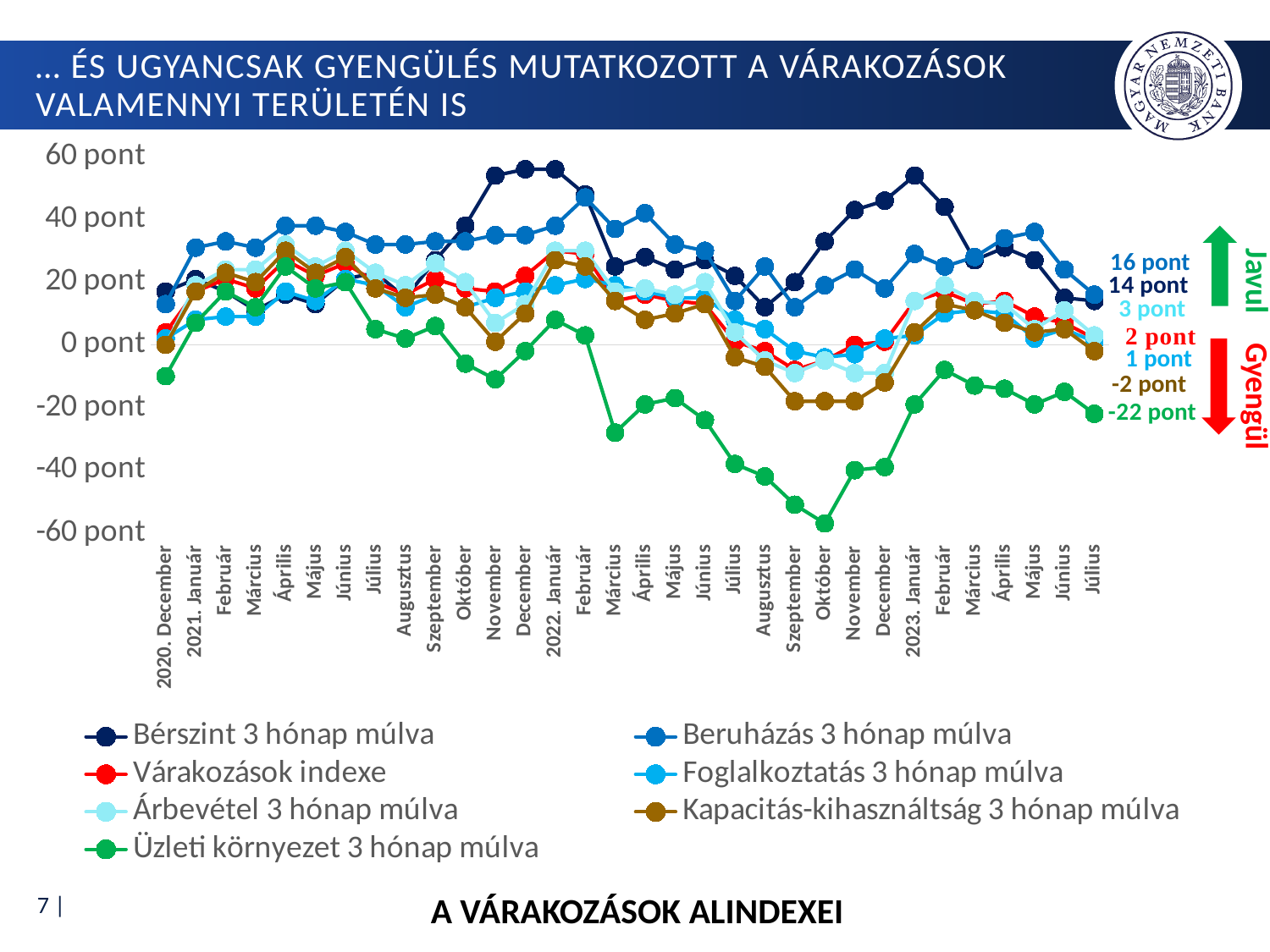
At the end of the chart, which is larger: the value for Árbevétel 3 hónap múlva or for Foglalkoztatás 3 hónap múlva? Árbevétel 3 hónap múlva What is the final value labelled for Várakozások indexe? 2 pont Which series has the highest labelled value at the end of the chart (2023 Július)? Beruházás 3 hónap múlva Is the value for Üzleti környezet 3 hónap múlva in 2022 Október greater or less than -40 pont? less What is the difference between the final labelled values of Beruházás 3 hónap múlva (16 pont) and Kapacitás-kihasználtság 3 hónap múlva (-2 pont)? 18 pont What is the final value labelled for Üzleti környezet 3 hónap múlva? -22 pont How many series does the legend list? 7 Is the value for Bérszint 3 hónap múlva in 2021 December greater or less than 40 pont? greater Which series has the lowest labelled value at the end of the chart (2023 Július)? Üzleti környezet 3 hónap múlva What is the final (2023 Július) value shown for Beruházás 3 hónap múlva? 16 pont What is the final value labelled for Bérszint 3 hónap múlva? 14 pont What kind of chart is shown on the slide? Line chart